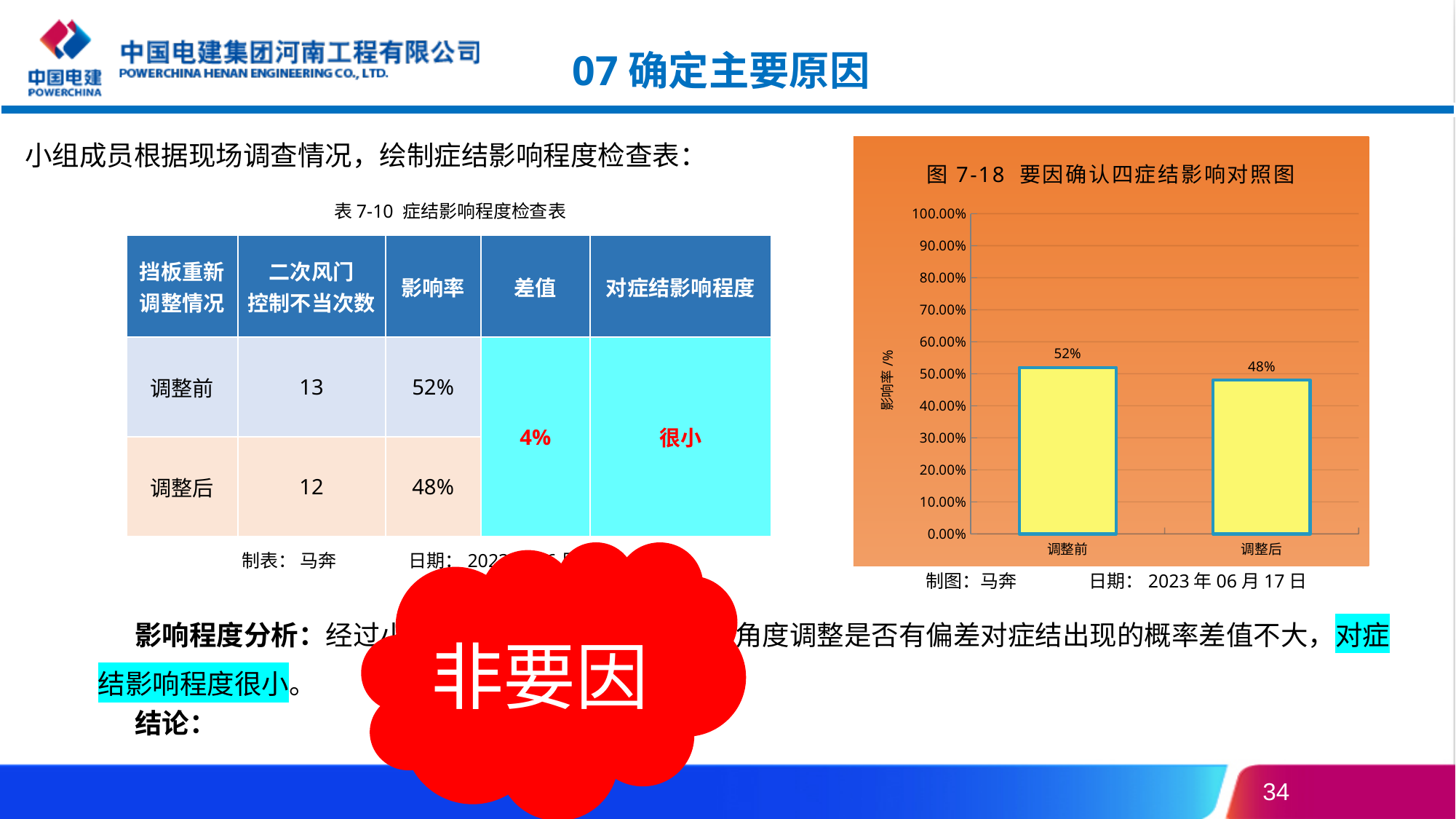
Is the value for 调整前 greater or less than 50.00% on the chart's axis? greater What is the value for 调整前 in the chart? 52% How many categories are shown on the x axis of the chart? 2 Which category has the lowest value in the chart? 调整后 What kind of chart is shown on the slide? bar chart Is the value for 调整后 greater or less than 50.00% on the chart's axis? less What is the value for 调整后 in the chart? 48% What is the difference between the values for 调整前 and 调整后 in the chart? 4% Do the values rise or fall from 调整前 to 调整后 in the chart? fall Which category has the highest value in the chart? 调整前 Which is larger in the chart, the value for 调整前 or the value for 调整后? 调整前 What is the title of the chart on the slide? 图 7-18 要因确认四症结影响对照图